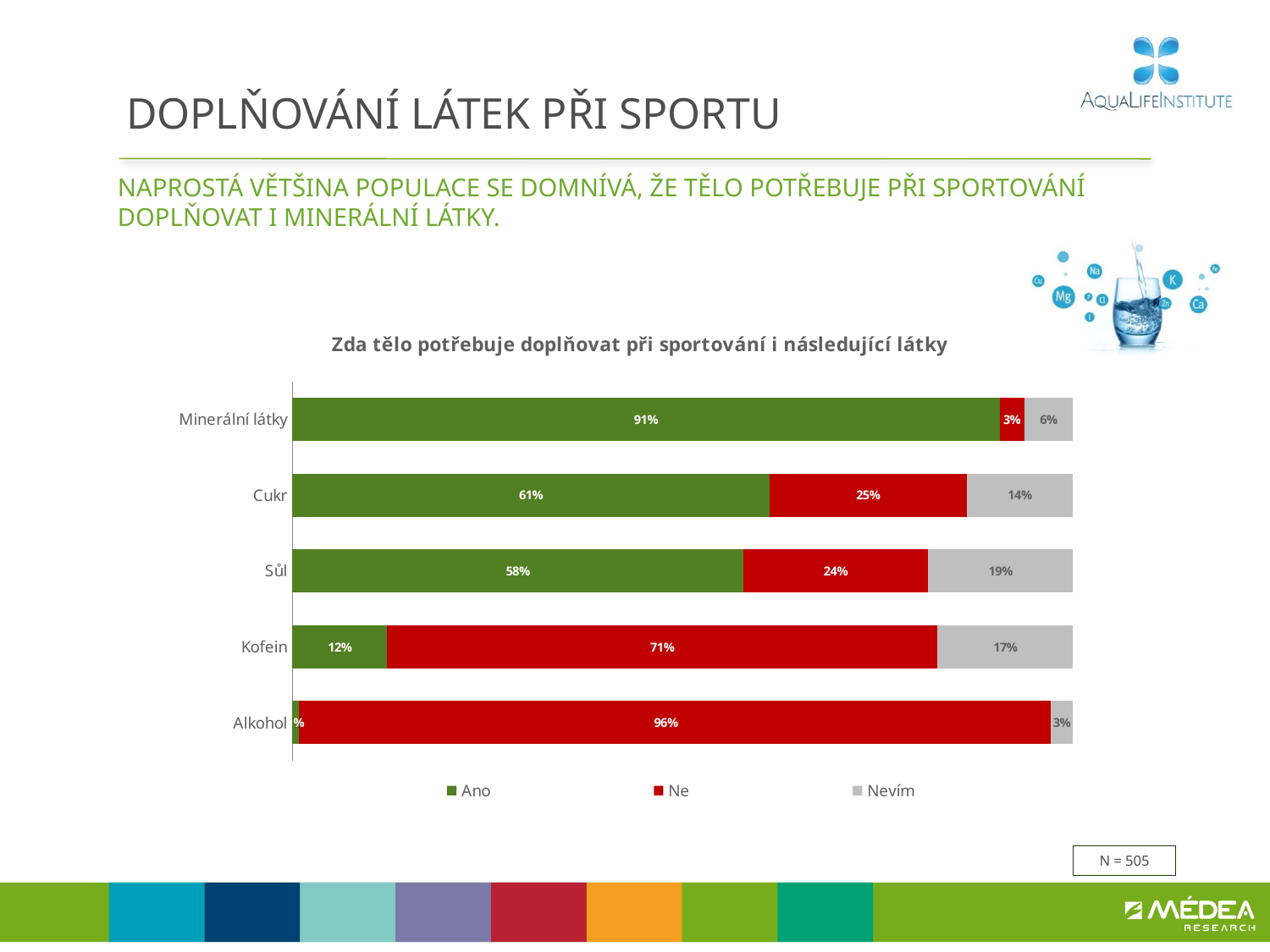
What is the 'Ano' value for Minerální látky? 91% Which category has the highest 'Ne' value? Alkohol Which category has the highest 'Ano' value? Minerální látky What is the 'Ne' value for Kofein? 71% What is the title of the chart? Zda tělo potřebuje doplňovat při sportování i následující látky Which is larger, the 'Ne' value for Cukr or the 'Ne' value for Sůl? Cukr What kind of chart is shown on the slide? Stacked bar chart How many categories are shown on the chart? 5 What is the difference between the 'Ano' values for Cukr and Sůl? 3% What is the 'Nevím' value for Sůl? 19% What is the total of the stacked bar for Kofein? 100% How many series does the legend list? 3